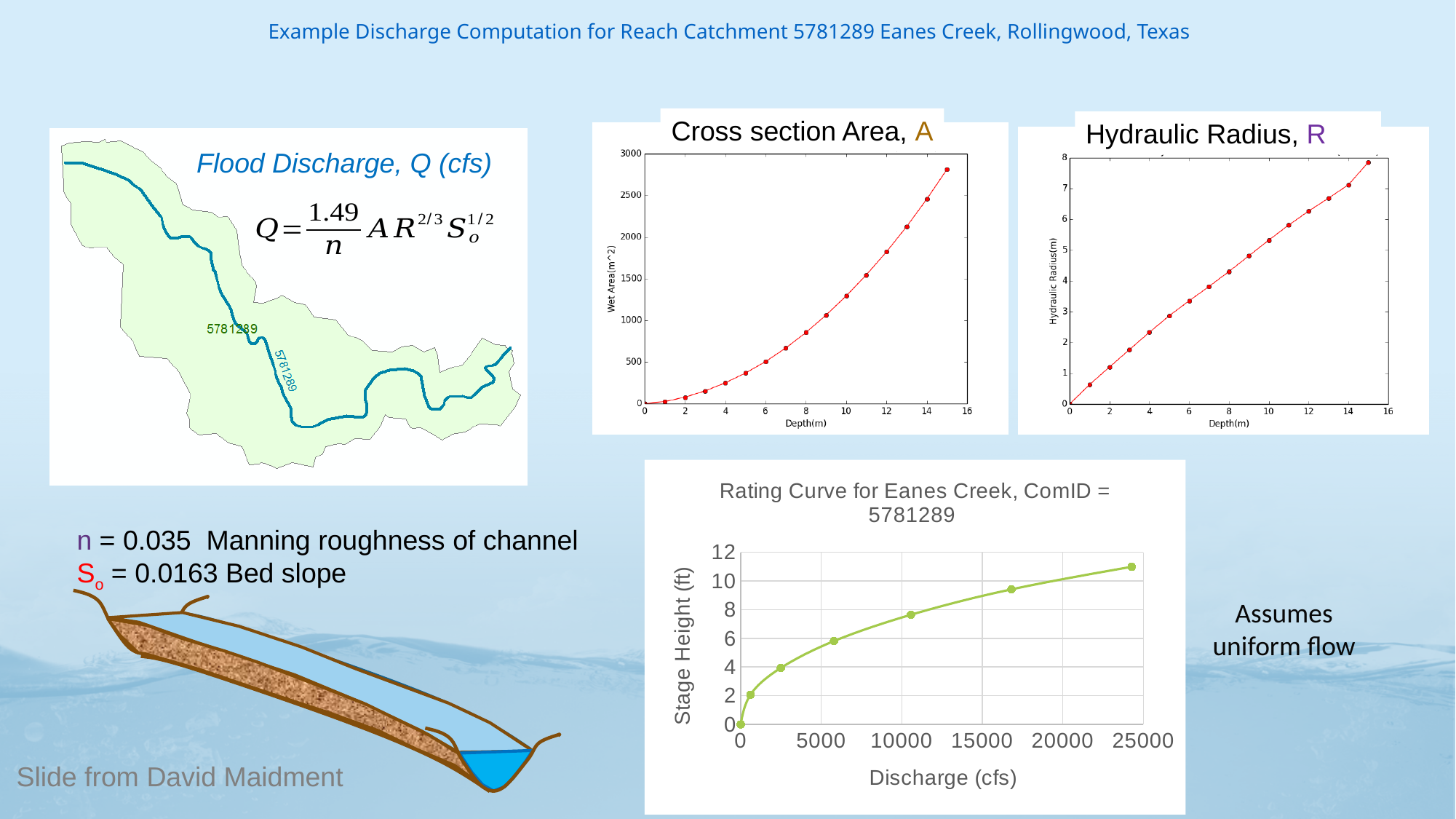
In the Cross section Area, A chart, does the wet area rise or fall as depth increases? rises In the Hydraulic Radius, R chart, is the hydraulic radius at a depth of 15 m greater or less than 7? greater What is the y-axis label of the Rating Curve for Eanes Creek chart? Stage Height (ft) In the Hydraulic Radius, R chart, does the hydraulic radius rise or fall as depth increases? rises What is the x-axis label of the Hydraulic Radius, R chart? Depth(m) In the Rating Curve for Eanes Creek chart, how many data points are plotted? 7 In the Cross section Area, A chart, is the wet area at a depth of 5 m greater or less than 500? less In the Cross section Area, A chart, is the wet area at a depth of 15 m greater or less than 2500? greater In the Rating Curve for Eanes Creek chart, does stage height rise or fall as discharge increases? rises What kind of chart is the Cross section Area, A chart? line chart